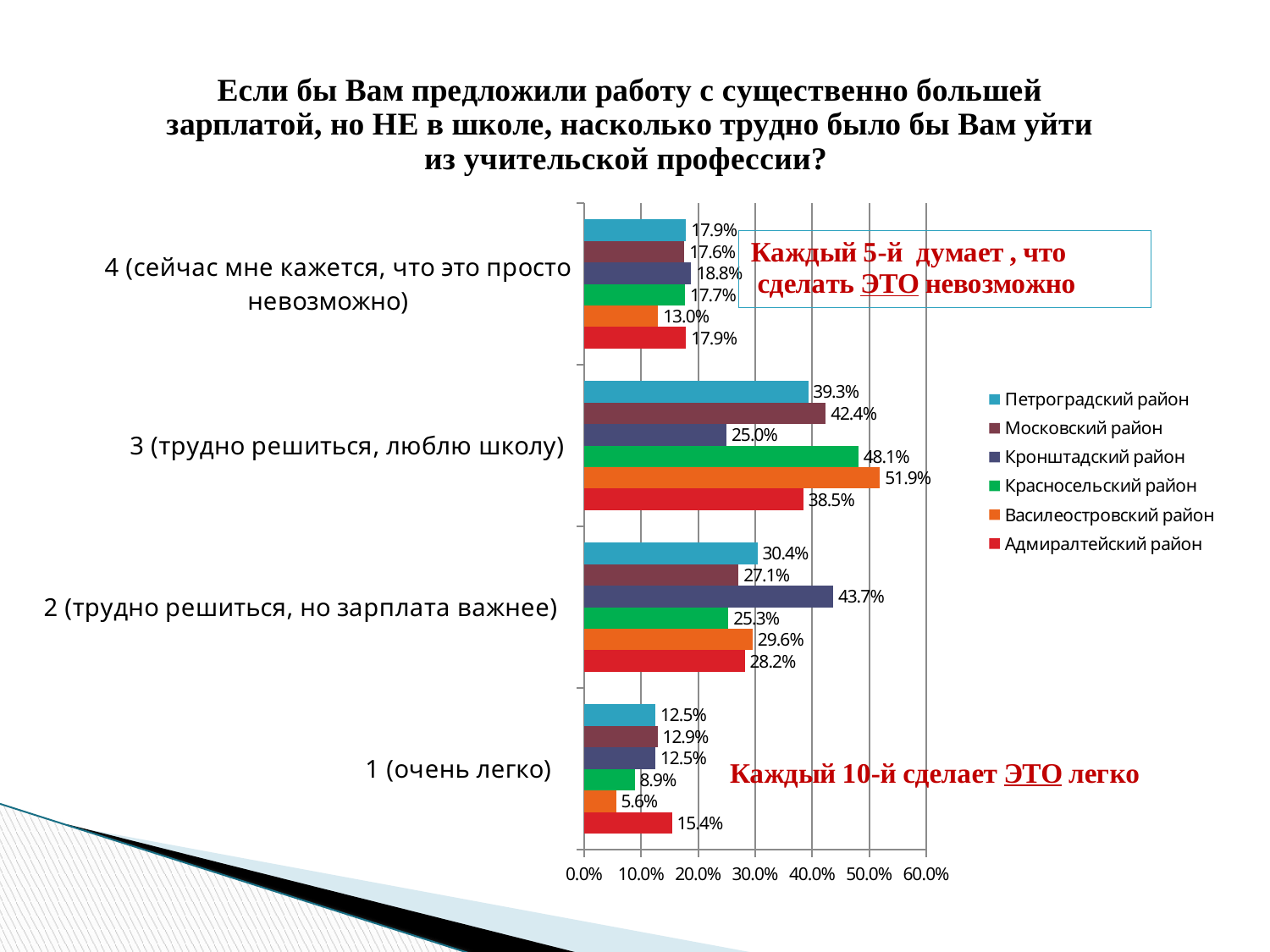
What kind of chart is shown on the slide? bar chart In the category "2 (трудно решиться, но зарплата важнее)", which is larger: Петроградский район or Красносельский район? Петроградский район Is the value for Красносельский район in the category "3 (трудно решиться, люблю школу)" greater or less than 40.0%? greater Which district has the highest value in the category "3 (трудно решиться, люблю школу)"? Василеостровский район How many series does the legend list? 6 What is the value for Василеостровский район in the category "3 (трудно решиться, люблю школу)"? 51.9% What is the difference between Василеостровский район and Кронштадский район in the category "3 (трудно решиться, люблю школу)"? 26.9% How many answer categories are shown on the vertical axis? 4 What is the value for Кронштадский район in the category "2 (трудно решиться, но зарплата важнее)"? 43.7% Which district has the lowest value in the category "1 (очень легко)"? Василеостровский район What is the value for Адмиралтейский район in the category "1 (очень легко)"? 15.4% Which district has the lowest value in the category "4 (сейчас мне кажется, что это просто невозможно)"? Василеостровский район